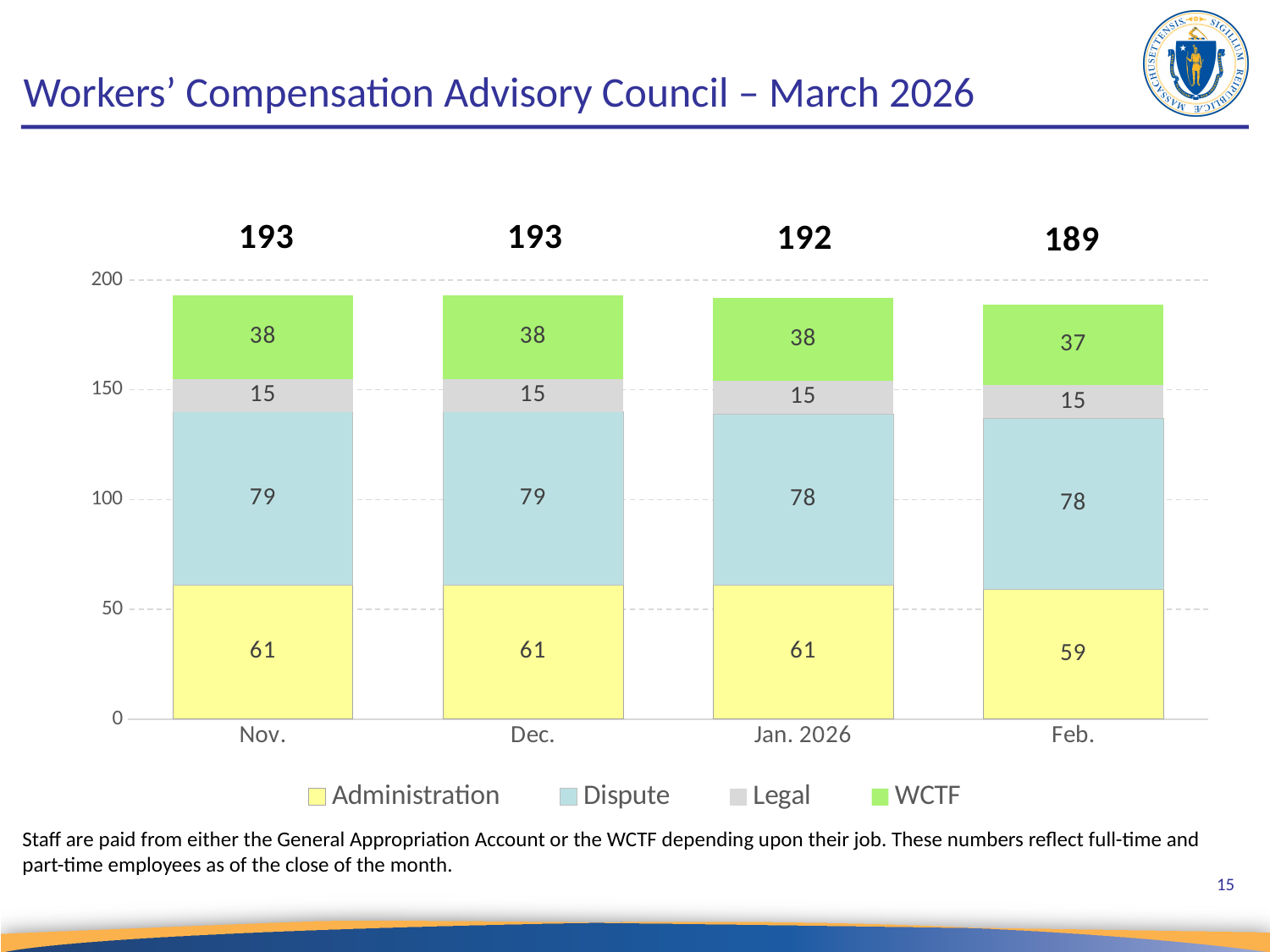
How many series does the legend list? 4 What is the WCTF value for Jan. 2026? 38 What is the total of the stacked bar for Dec.? 193 Which is larger in Jan. 2026, the Dispute value or the Administration value? Dispute How many months are shown on the x axis? 4 Which month has the lowest total? Feb. Do the bar totals rise or fall from Nov. to Feb.? Fall What is the total of the stacked bar for Feb.? 189 What is the Dispute value for Nov.? 79 What is the Administration value for Feb.? 59 What is the difference between the Nov. total and the Feb. total? 4 What kind of chart is shown? Stacked bar chart